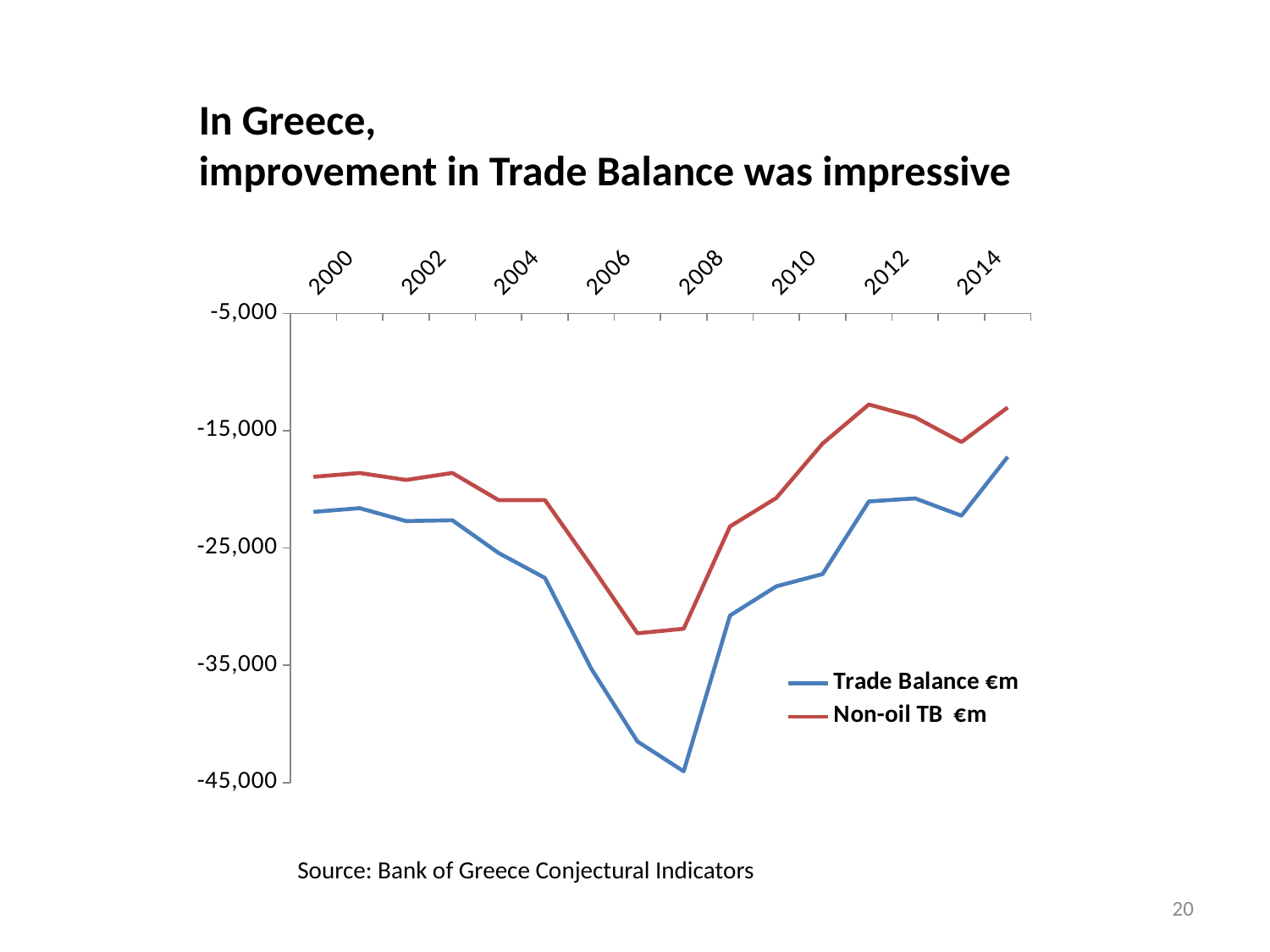
Is the Non-oil TB €m value in 2008 greater or less than -35,000? greater Does the Trade Balance €m series rise or fall between 2004 and 2008? fall Which series is plotted above the other across the whole chart? Non-oil TB €m Is the Trade Balance €m value in 2008 greater or less than -35,000? less In which year does the Trade Balance €m series reach its lowest value? 2008 Does the Trade Balance €m series rise or fall between 2008 and 2012? rise In 2008, which series has the higher value, Trade Balance €m or Non-oil TB €m? Non-oil TB €m How many series does the chart's legend list? 2 Is the Non-oil TB €m value in 2000 greater or less than -25,000? greater What kind of chart is shown on the slide? Line chart What are the two series named in the legend? Trade Balance €m and Non-oil TB €m